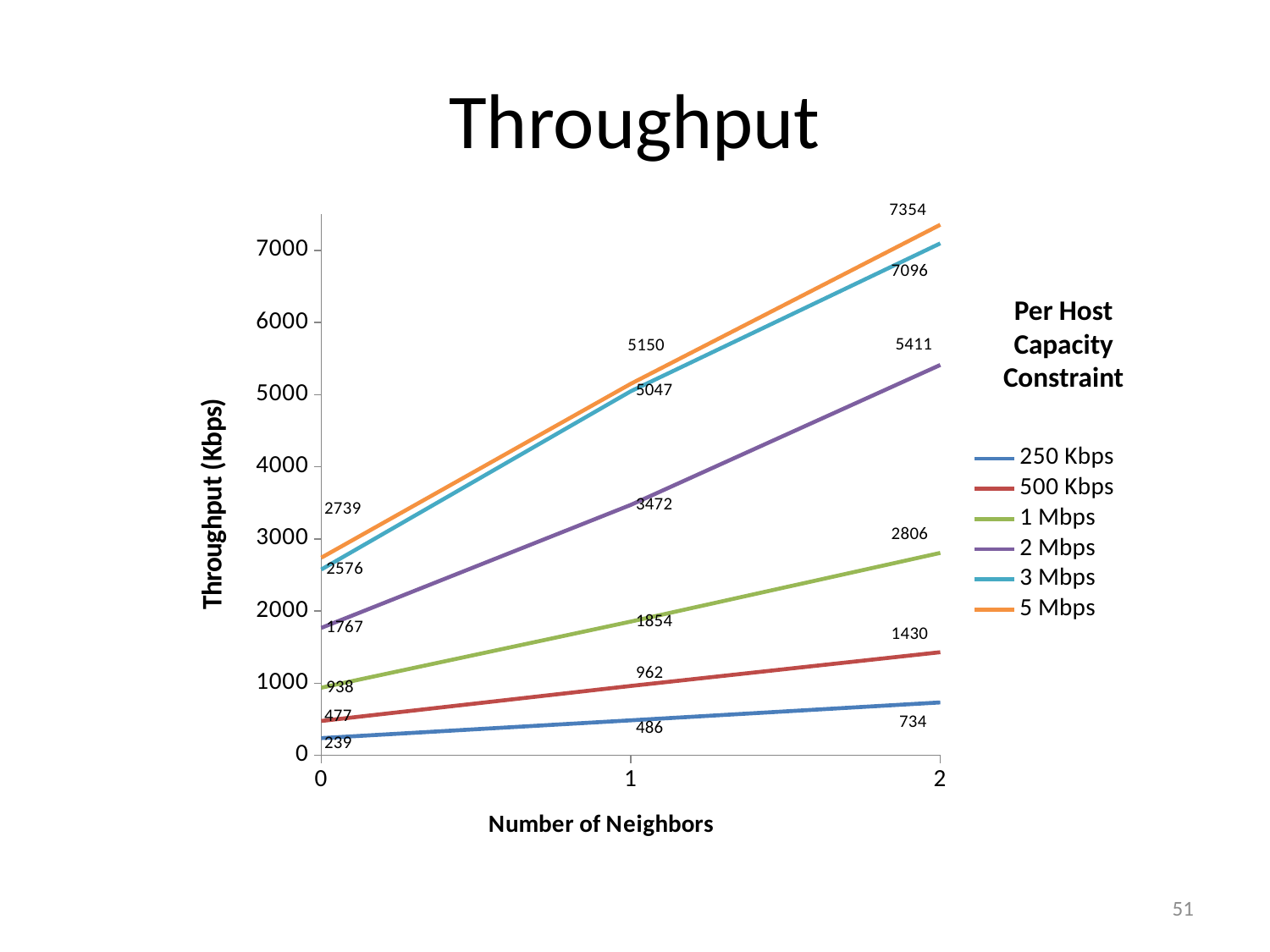
What is the throughput for the 2 Mbps series at 1 neighbor? 3472 What type of chart is shown on the slide? line chart What is the difference between the 3 Mbps and 2 Mbps throughput at 2 neighbors? 1685 How many series does the legend list? 6 What is the throughput for the 5 Mbps series at 2 neighbors? 7354 Does the throughput for the 2 Mbps series rise or fall as the number of neighbors increases? rise What is the throughput for the 250 Kbps series at 0 neighbors? 239 What is the throughput for the 1 Mbps series at 2 neighbors? 2806 What is the title of the x axis? Number of Neighbors Which series has the highest throughput at 2 neighbors? 5 Mbps Which is larger at 1 neighbor: the 500 Kbps throughput or the 1 Mbps throughput? 1 Mbps Which series has the lowest throughput at 1 neighbor? 250 Kbps